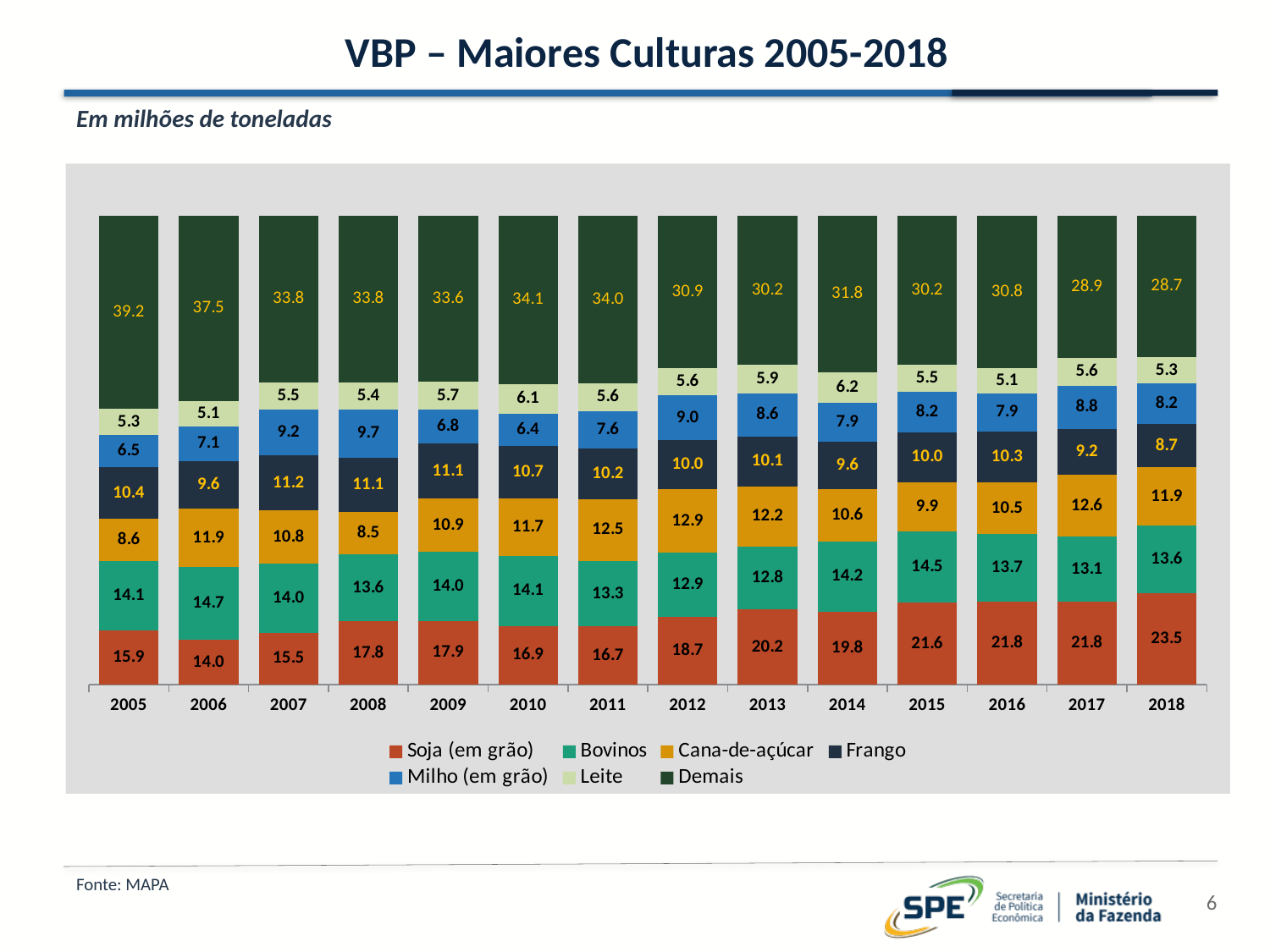
What is the value for Demais in 2005? 39.2 What is the value for Frango in 2016? 10.3 In which year is the Soja (em grão) value highest? 2018 In 2015, which is larger: Bovinos or Cana-de-açúcar? Bovinos In which year is the Demais value lowest? 2018 How many series does the legend list? 7 What kind of chart is shown on the slide? Stacked bar chart What is the difference between the Soja (em grão) values for 2018 and 2005? 7.6 What is the value for Milho (em grão) in 2008? 9.7 What is the value for Soja (em grão) in 2018? 23.5 What is the value for Bovinos in 2006? 14.7 How many years are shown on the x axis? 14